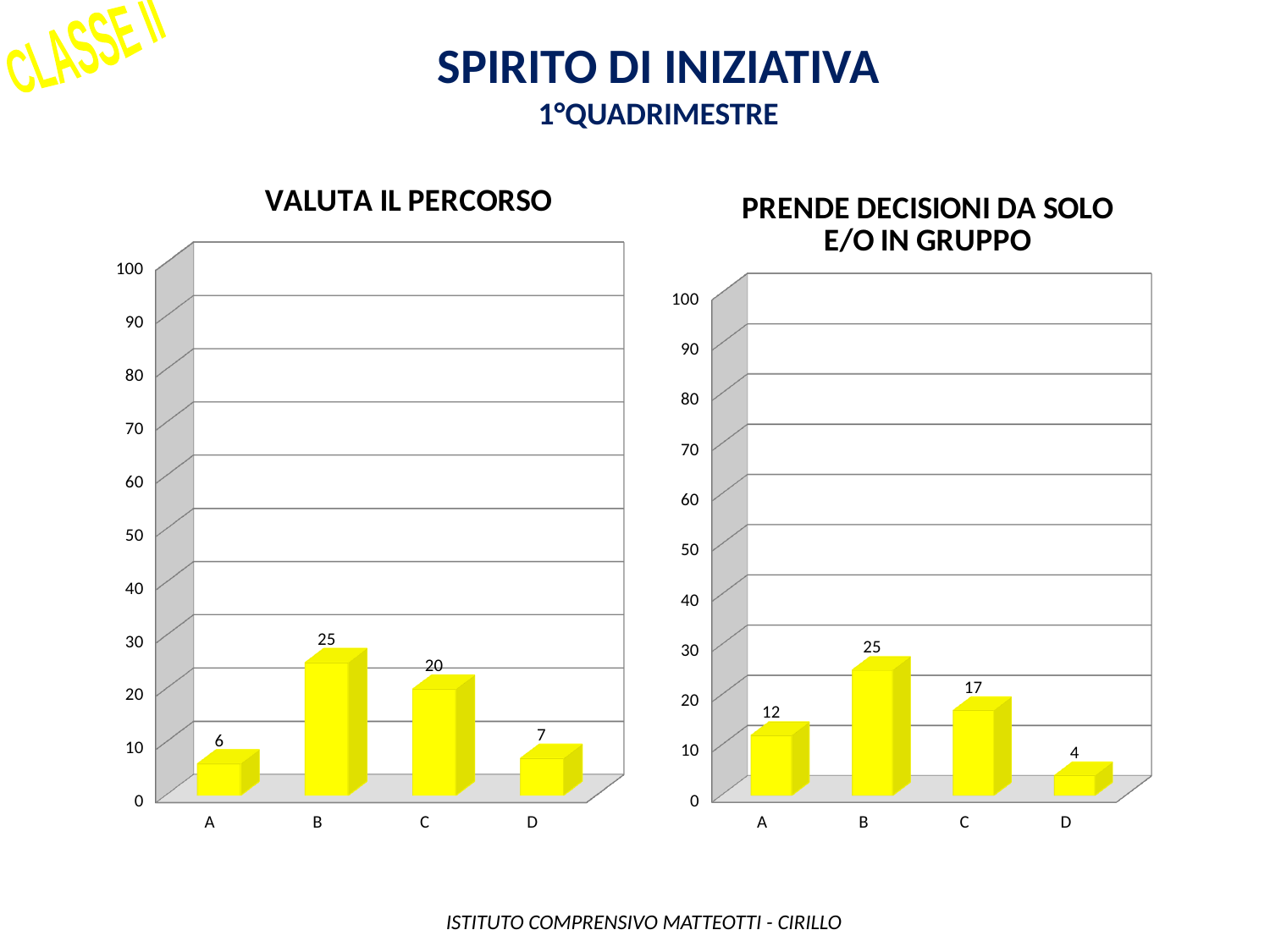
In the 'VALUTA IL PERCORSO' chart, what is the value for category B? 25 In the 'VALUTA IL PERCORSO' chart, what is the difference between the values for B and C? 5 In the 'PRENDE DECISIONI DA SOLO E/O IN GRUPPO' chart, what is the value for category D? 4 In the 'VALUTA IL PERCORSO' chart, which is larger, the value for A or the value for D? D In the 'PRENDE DECISIONI DA SOLO E/O IN GRUPPO' chart, what is the difference between the values for A and D? 8 In the 'PRENDE DECISIONI DA SOLO E/O IN GRUPPO' chart, which category has the lowest value? D In the 'PRENDE DECISIONI DA SOLO E/O IN GRUPPO' chart, what is the value for category C? 17 What kind of chart is the 'PRENDE DECISIONI DA SOLO E/O IN GRUPPO' chart? Bar chart In the 'VALUTA IL PERCORSO' chart, what is the value for category A? 6 In the 'PRENDE DECISIONI DA SOLO E/O IN GRUPPO' chart, is the value for B greater or less than 20? greater In the 'VALUTA IL PERCORSO' chart, which category has the highest value? B How many categories are shown on the x axis of the 'VALUTA IL PERCORSO' chart? 4